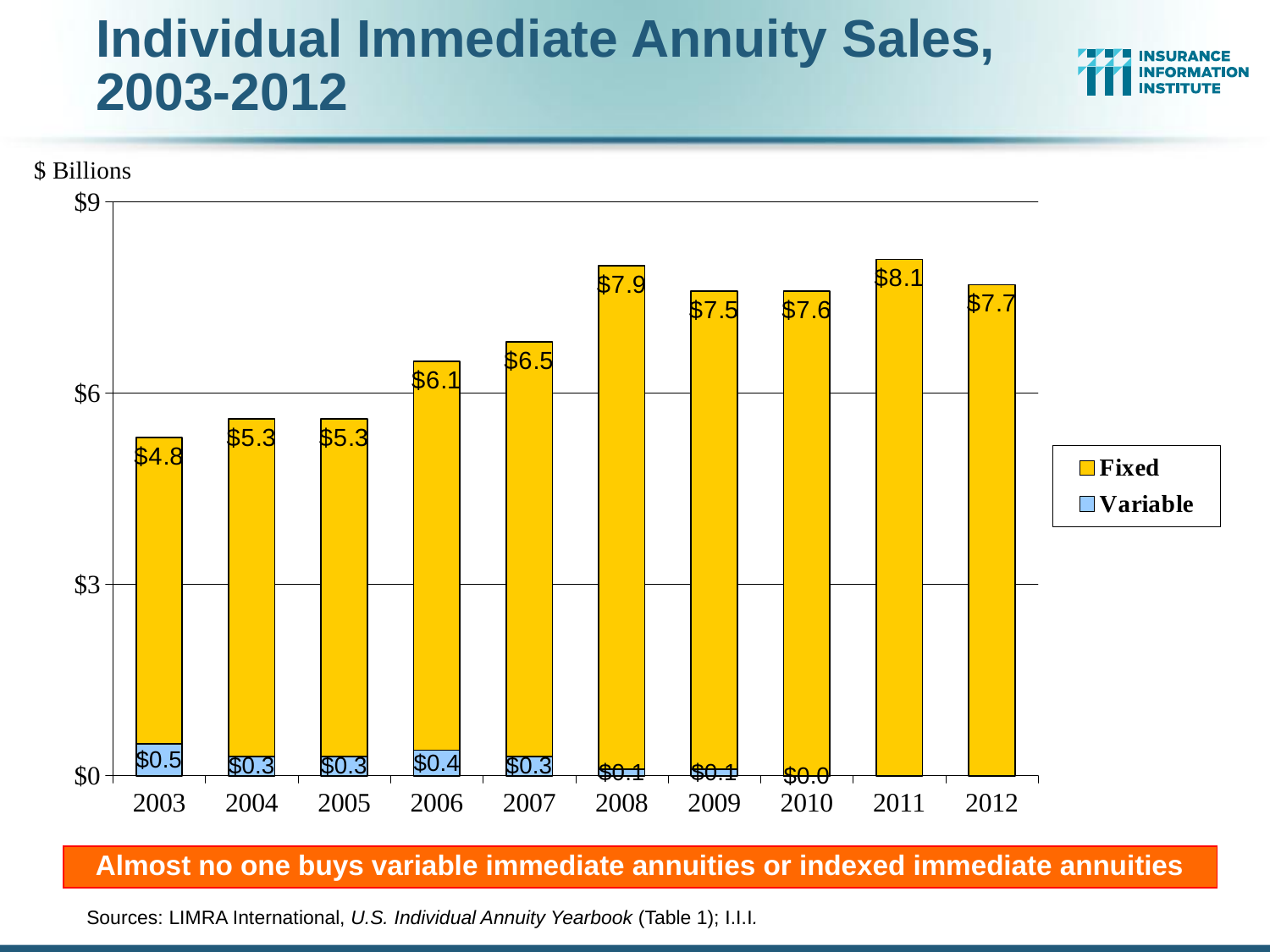
What is the total of the stacked bar for 2003 (Fixed plus Variable)? $5.3 How many years are shown on the x axis of the chart? 10 What is the difference between the Fixed value in 2011 and the Fixed value in 2003? $3.3 What is the Variable immediate annuity sales value for 2003? $0.5 How many series does the legend list? 2 What is the Fixed immediate annuity sales value for 2008? $7.9 Which year has the lowest Fixed immediate annuity sales? 2003 Which year has the highest Fixed immediate annuity sales? 2011 Do Fixed immediate annuity sales generally rise or fall from 2003 to 2011? Rise What is the Fixed value shown for 2012? $7.7 What kind of chart is shown on the slide? Stacked bar chart Which year has the larger Fixed value, 2008 or 2009? 2008